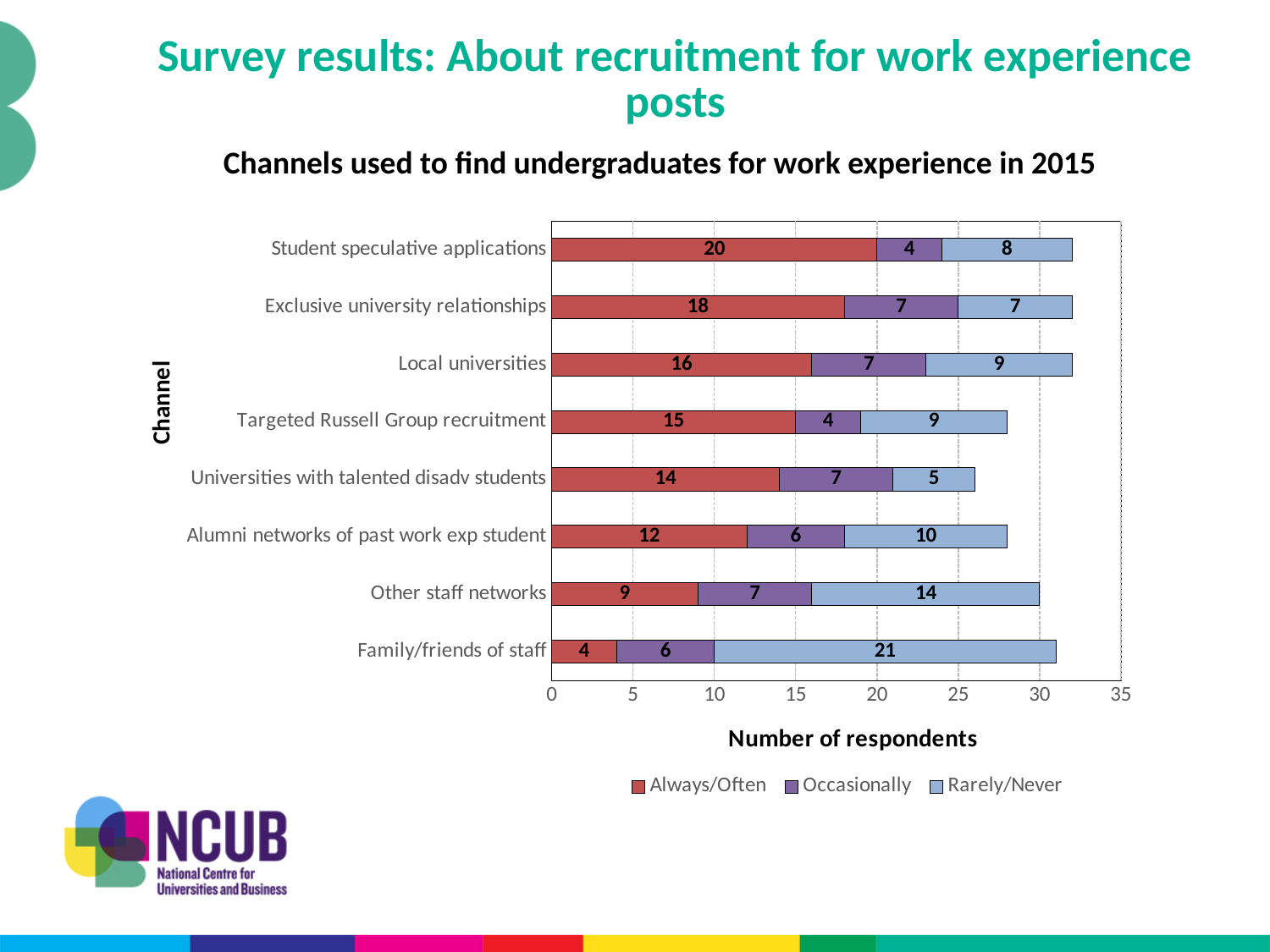
What is the Occasionally value for Alumni networks of past work exp student? 6 What is the label of the x axis? Number of respondents Which is larger: the Rarely/Never value for Other staff networks or for Alumni networks of past work exp student? Other staff networks What kind of chart is shown on the slide? Stacked bar chart What is the Rarely/Never value for Family/friends of staff? 21 What is the Always/Often value for Student speculative applications? 20 How many series does the legend list? 3 Which channel has the lowest Always/Often value? Family/friends of staff Which channel has the highest Always/Often value? Student speculative applications How many channels (categories) are plotted on the chart? 8 What is the difference between the Always/Often values for Exclusive university relationships and Local universities? 2 What is the total number of respondents for Targeted Russell Group recruitment? 28